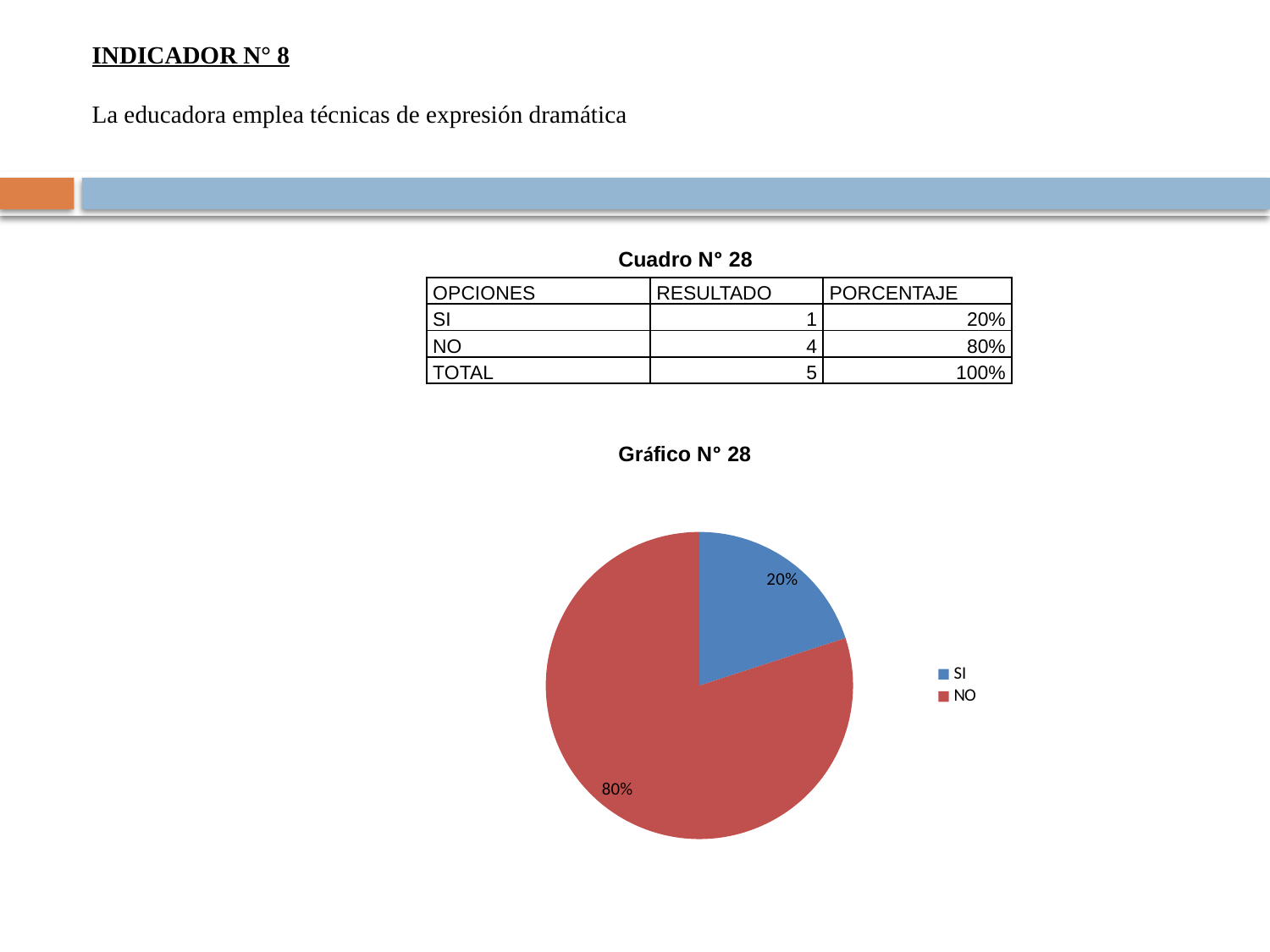
What share of the pie does the SI slice take? 20% What kind of chart is shown on the slide? pie chart What colour is the NO slice in the pie chart? red Which category has the smallest slice in the pie chart? SI How many slices does the pie chart have? 2 What percentage does the SI slice represent in the pie chart? 20% Which slice is larger in the pie chart, SI or NO? NO Which category has the largest slice in the pie chart? NO What is the difference in percentage points between the NO slice and the SI slice? 60% What is the title of the chart on the slide? Gráfico N° 28 How many entries does the legend of the pie chart list? 2 What percentage does the NO slice represent in the pie chart? 80%